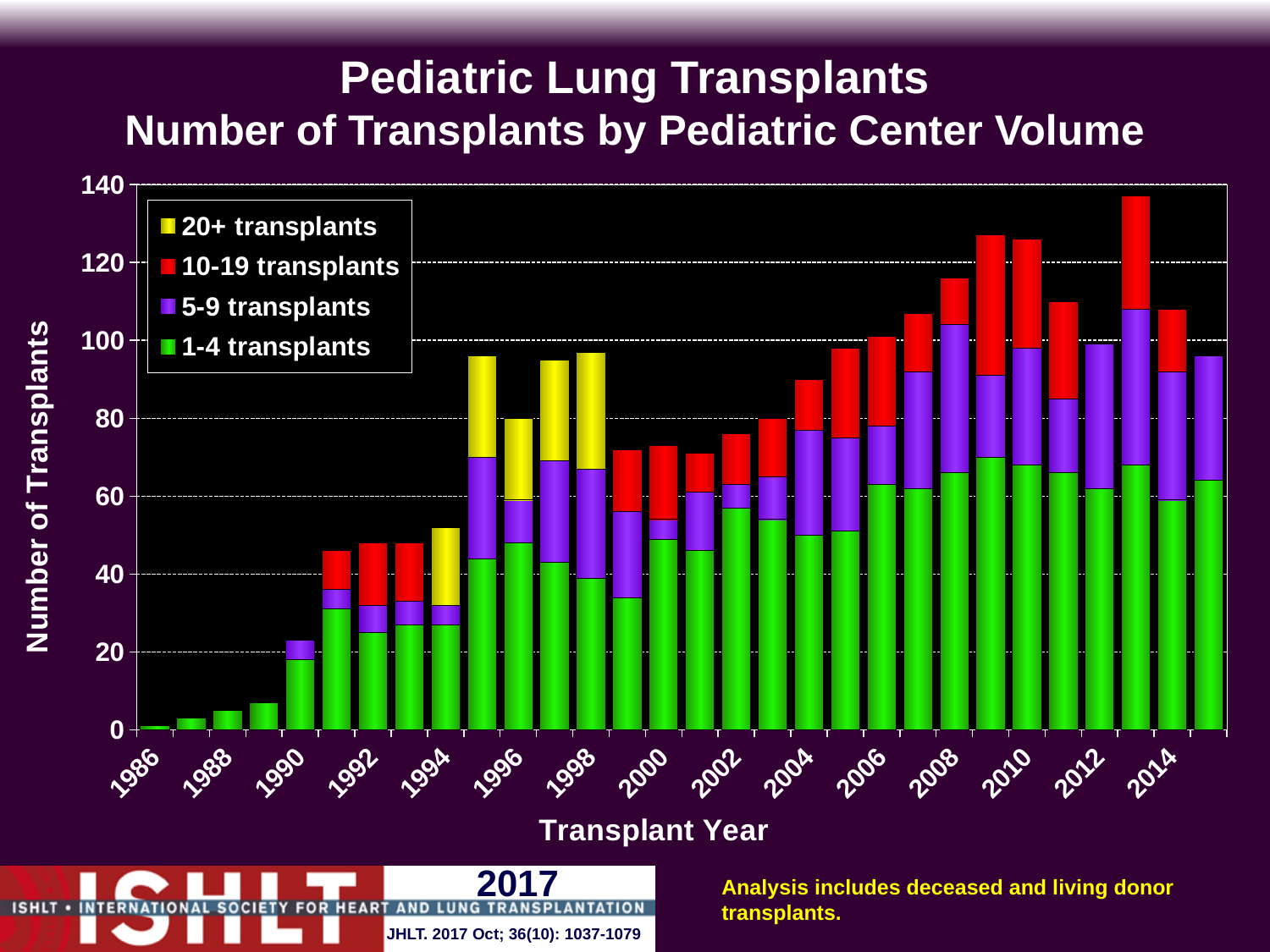
Do the total numbers of transplants rise or fall from 2003 to 2009? rise Which colour represents the '20+ transplants' series in the legend? Yellow Is the total number of transplants for 1994 greater or less than 60? less Which transplant year has the lowest total number of transplants? 1986 How many series does the legend list? 4 Which year has a larger total number of transplants, 2013 or 2014? 2013 Which year has a larger total number of transplants, 1995 or 1996? 1995 How many transplant years (bars) are plotted on the chart? 30 Which transplant year has the highest total number of transplants? 2013 Is the total number of transplants for 2000 greater or less than 60? greater Is the total number of transplants for 2013 greater or less than 120? greater What kind of chart is shown on the slide? Stacked bar chart